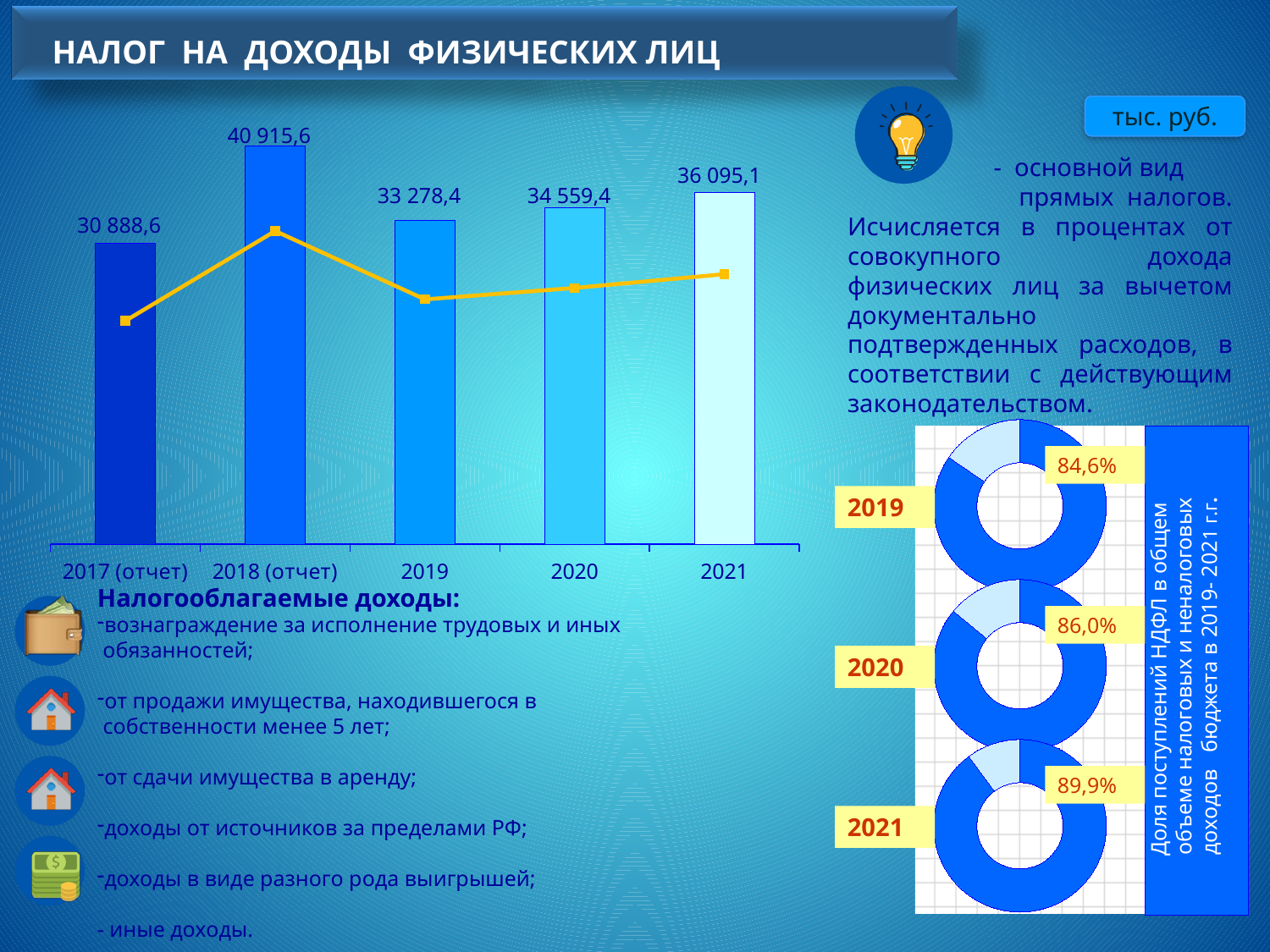
In the donut charts on the right, what is the share shown for 2020? 86,0% In the bar chart on the left, what is the value for 2018 (отчет)? 40 915,6 In the bar chart on the left, do the values rise or fall from 2019 to 2021? rise In the bar chart on the left, what is the difference between the values for 2021 and 2020? 1 535,7 How many years (categories) are shown in the bar chart on the left? 5 In the bar chart on the left, which year has the lowest value? 2017 (отчет) In the bar chart on the left, which is larger: the value for 2019 or the value for 2020? 2020 In the bar chart on the left, what is the difference between the values for 2018 (отчет) and 2017 (отчет)? 10 027,0 In the bar chart on the left, what is the value for 2021? 36 095,1 In the donut charts on the right, which year has the highest share? 2021 In the bar chart on the left, which year has the highest value? 2018 (отчет) What unit is indicated for the values in the bar chart on the left? тыс. руб.